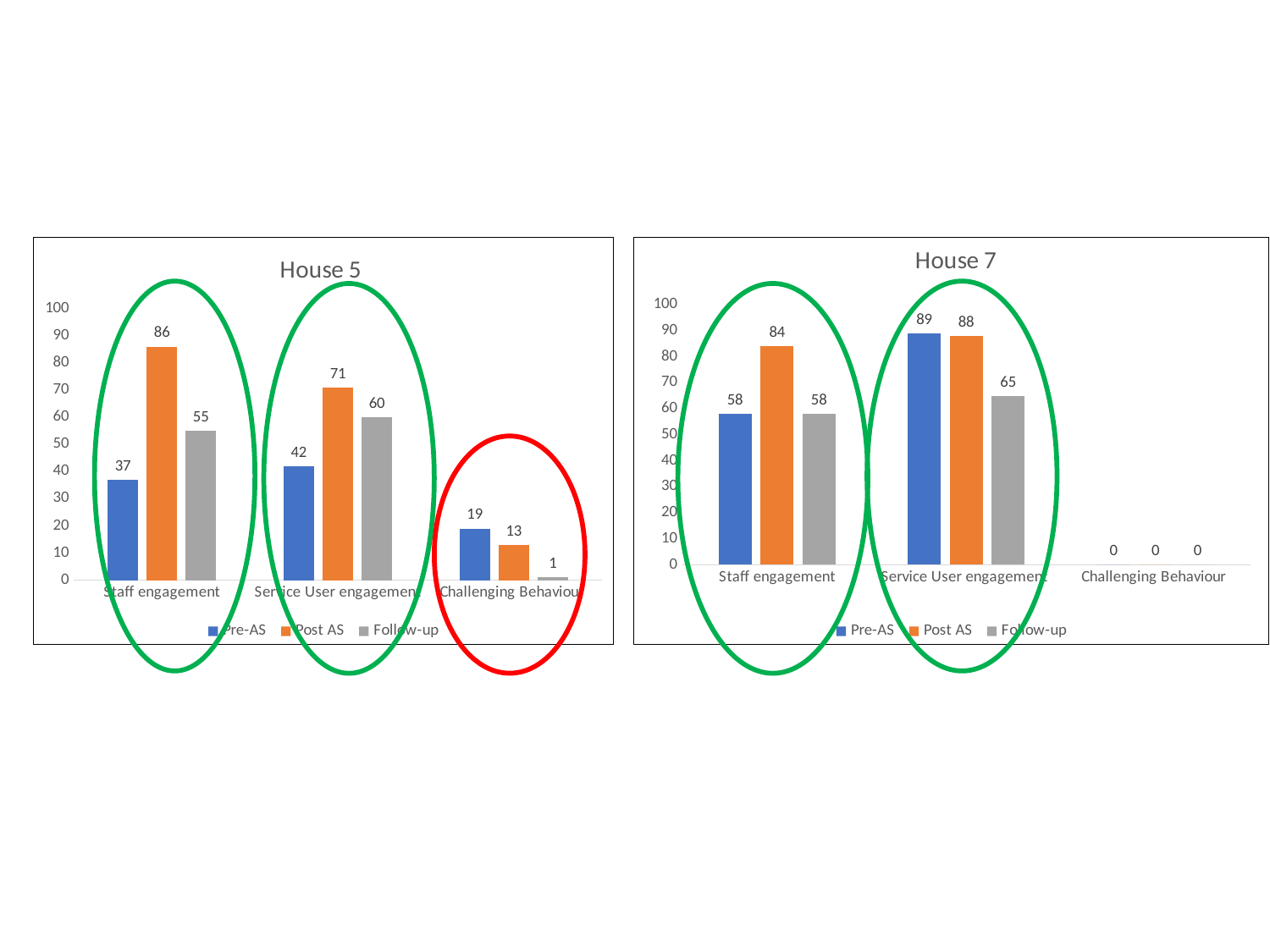
In the House 7 chart, what is the difference between the Post AS and Pre-AS values for Staff engagement? 26 In the House 5 chart, what is the Post AS value for Staff engagement? 86 In the House 5 chart, which category has the highest Pre-AS value? Service User engagement In the House 7 chart, which category has the lowest Post AS value? Challenging Behaviour In the House 5 chart, which is larger for Service User engagement: the Post AS value or the Follow-up value? Post AS In the House 7 chart, what is the Pre-AS value for Service User engagement? 89 In the House 5 chart, what is the Follow-up value for Challenging Behaviour? 1 In the House 5 chart, what is the difference between the Post AS and Pre-AS values for Staff engagement? 49 What type of chart is the House 7 chart? Bar chart How many categories are shown on the x axis of the House 7 chart? 3 How many series does the legend of the House 5 chart list? 3 In the House 7 chart, what is the Follow-up value for Service User engagement? 65